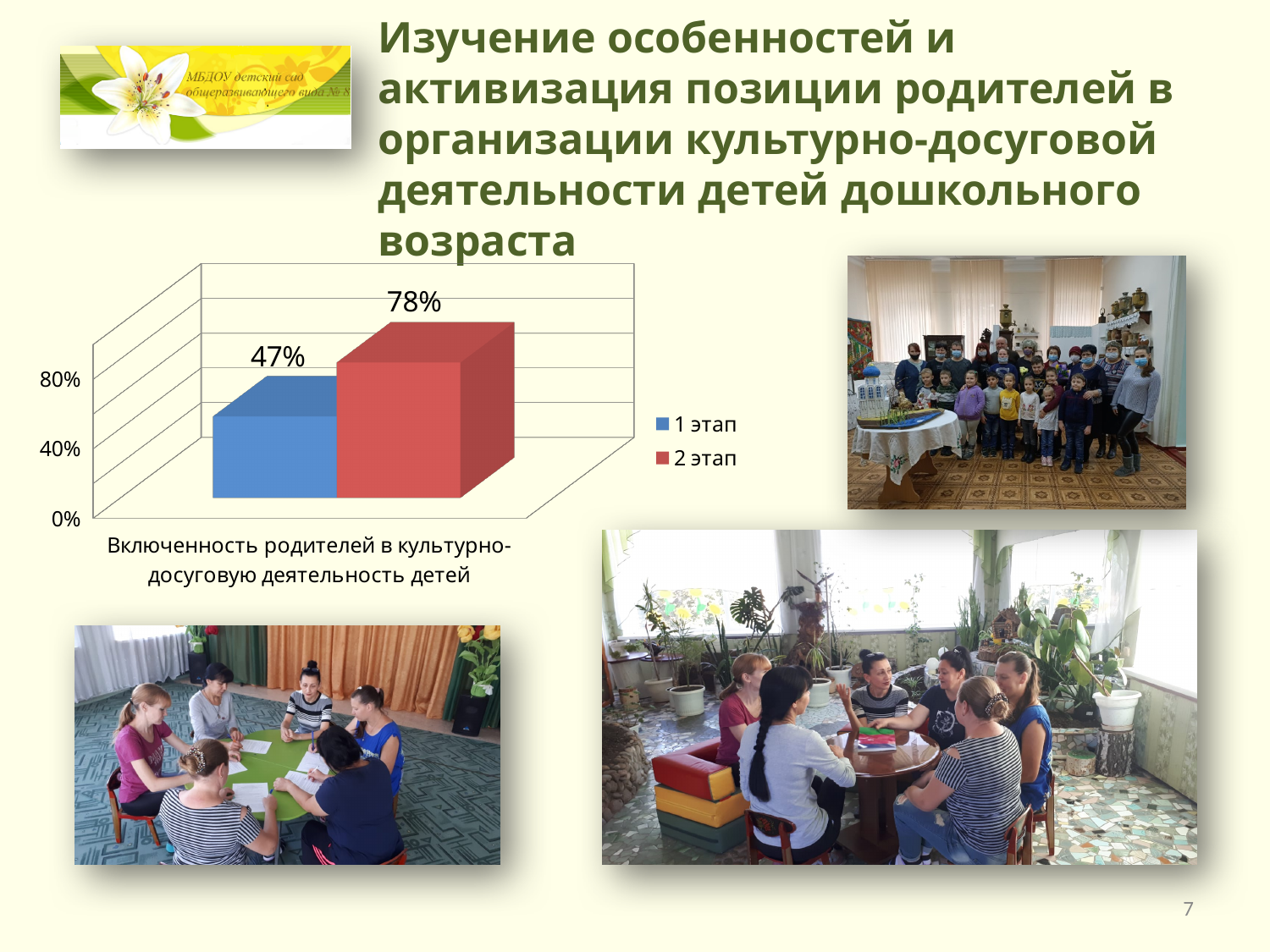
How many series does the legend list? 2 Is the value for "1 этап" greater or less than 40%? greater What is the difference between the values for "2 этап" and "1 этап"? 31% What is the value for "2 этап" in the chart? 78% Which series has the lowest value in the chart? 1 этап What kind of chart is shown on the slide? bar chart Is the value for "2 этап" greater or less than 80%? less What is the category label shown below the chart? Включенность родителей в культурно-досуговую деятельность детей What colour is the bar for "2 этап"? red How many categories are shown on the x axis of the chart? 1 Which series has the higher value, "1 этап" or "2 этап"? 2 этап What is the value for "1 этап" in the chart? 47%